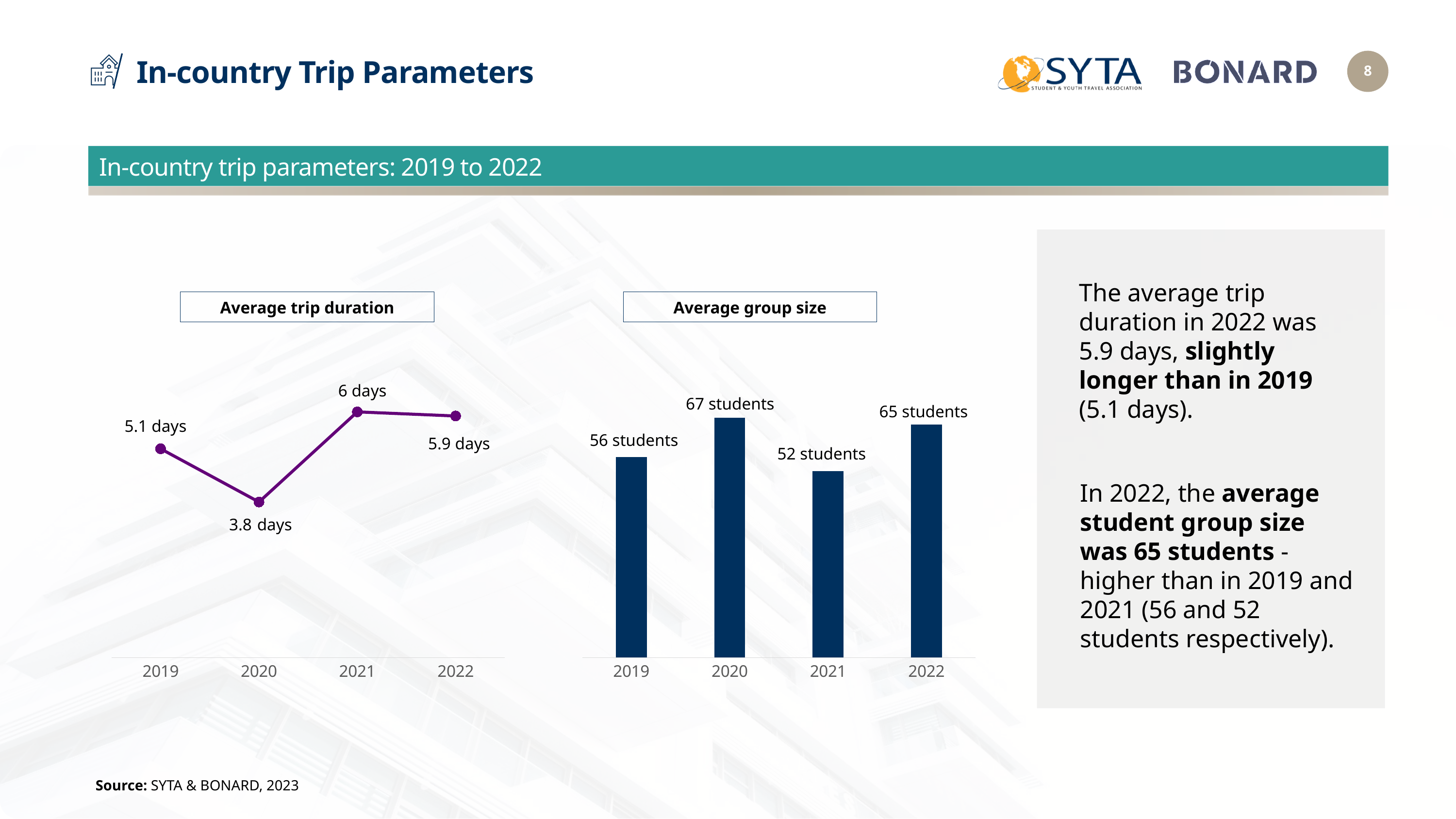
In the 'Average group size' chart, what is the difference between the 2020 and 2019 values? 11 students In the 'Average group size' chart, which year had the largest average group size? 2020 In the 'Average trip duration' chart, which year had the shortest average trip duration? 2020 In the 'Average trip duration' chart, what is the difference between the 2022 and 2019 values? 0.8 days In the 'Average trip duration' chart, what was the average trip duration in 2022? 5.9 days In the 'Average trip duration' chart, which year had the longest average trip duration? 2021 In the 'Average group size' chart, what was the average group size in 2021? 52 students In the 'Average group size' chart, which is larger: the value for 2019 or the value for 2022? 2022 What kind of chart is the 'Average trip duration' chart? Line chart How many years are shown on the x axis of the 'Average group size' chart? 4 In the 'Average trip duration' chart, what was the average trip duration in 2020? 3.8 days In the 'Average group size' chart, which year had the smallest average group size? 2021